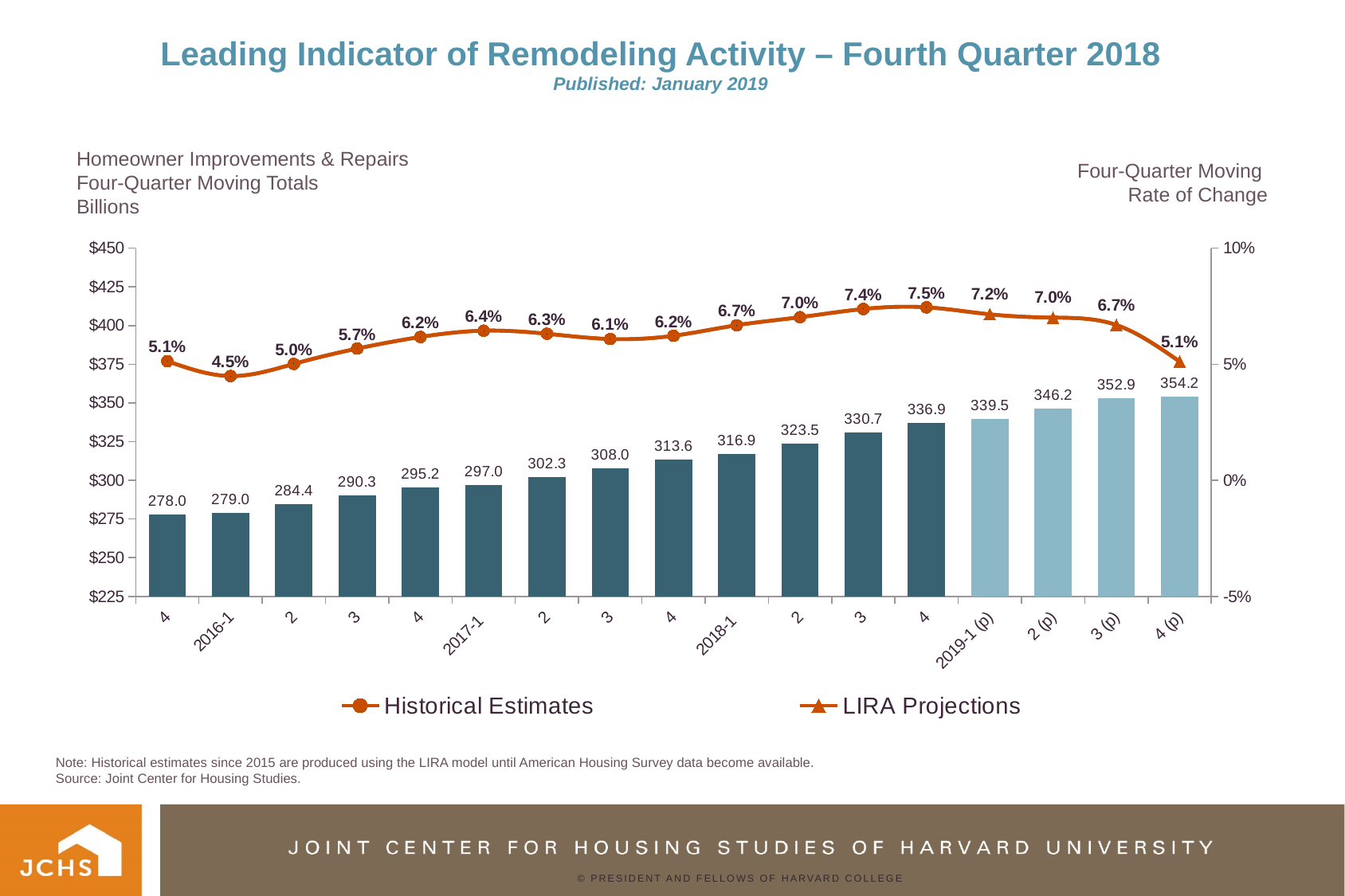
In which quarter is the four-quarter moving rate of change lowest? 2016-1 (4.5%) Do the four-quarter moving totals rise or fall from the first quarter to the last quarter shown? Rise What is the four-quarter moving rate of change shown for the third quarter of 2018? 7.4% What is the four-quarter moving total for 2018-1? 316.9 What kind of chart is shown on the slide? Combined bar and line chart What is the four-quarter moving rate of change for 2017-1? 6.4% What is the projected four-quarter moving total for 4 (p) of 2019? 354.2 Which is larger, the rate of change for 2019-1 (p) or the rate of change for 3 (p) of 2019? 2019-1 (p) How many quarters are plotted along the x axis? 17 How many series does the legend list? 2 In which quarter does the four-quarter moving rate of change reach its highest value? 2018-4 (7.5%) What is the difference between the four-quarter moving total for 4 (p) of 2019 and the total for the fourth quarter of 2018? 17.3